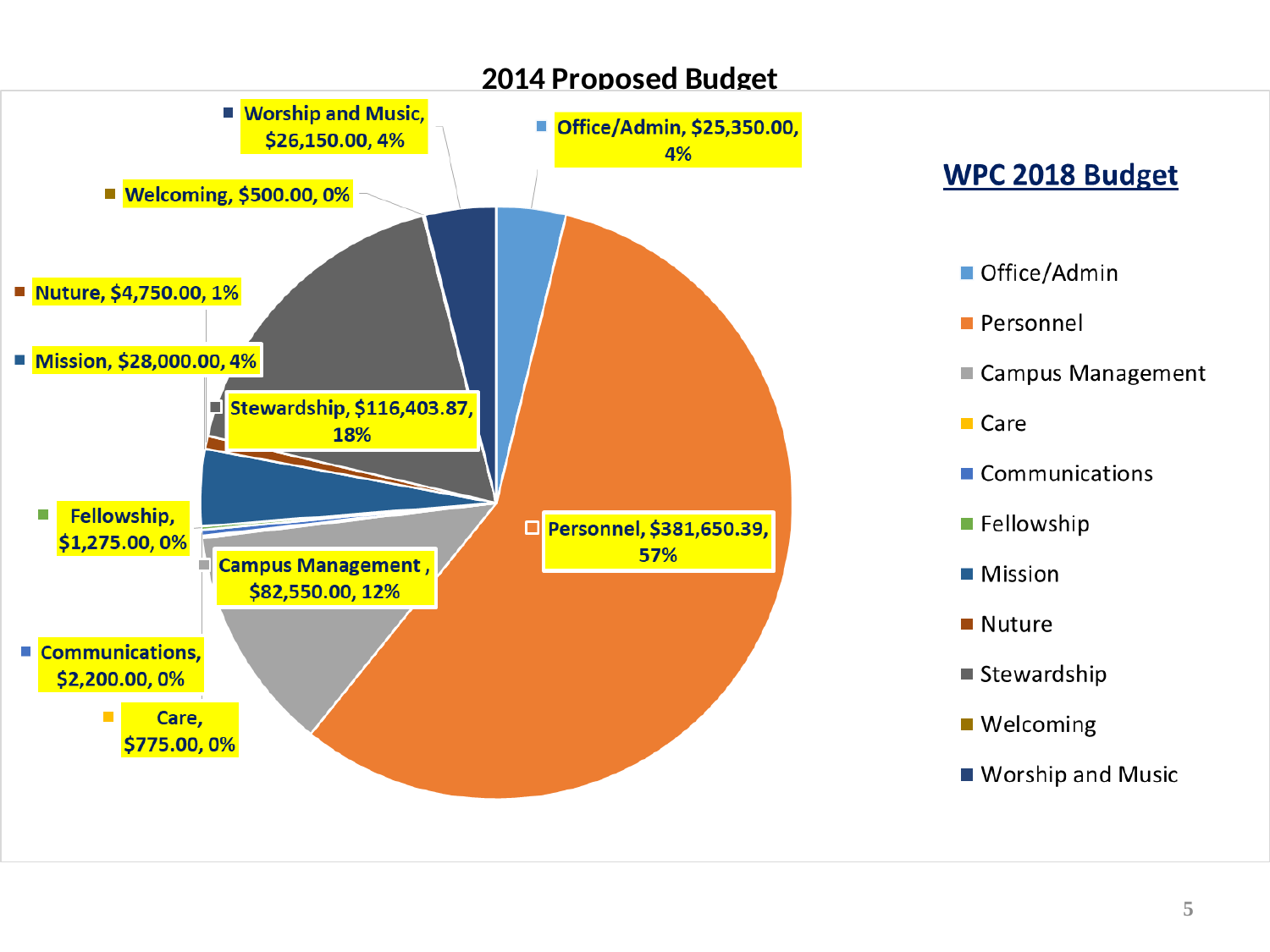
What is the title of the chart? 2014 Proposed Budget What is the value for Personnel? $381,650.39 Which category has the largest slice of the pie? Personnel What is the value for Stewardship? $116,403.87 What is the value for Campus Management? $82,550.00 How many categories are shown in the pie chart? 11 What percentage share of the pie does Stewardship represent? 18% Which category has the smallest value? Welcoming What is the difference between the Mission value and the Office/Admin value? $2,650.00 What percentage share of the pie does Personnel represent? 57% What type of chart is shown on the slide? Pie chart Which is larger, the value for Worship and Music or the value for Mission? Mission